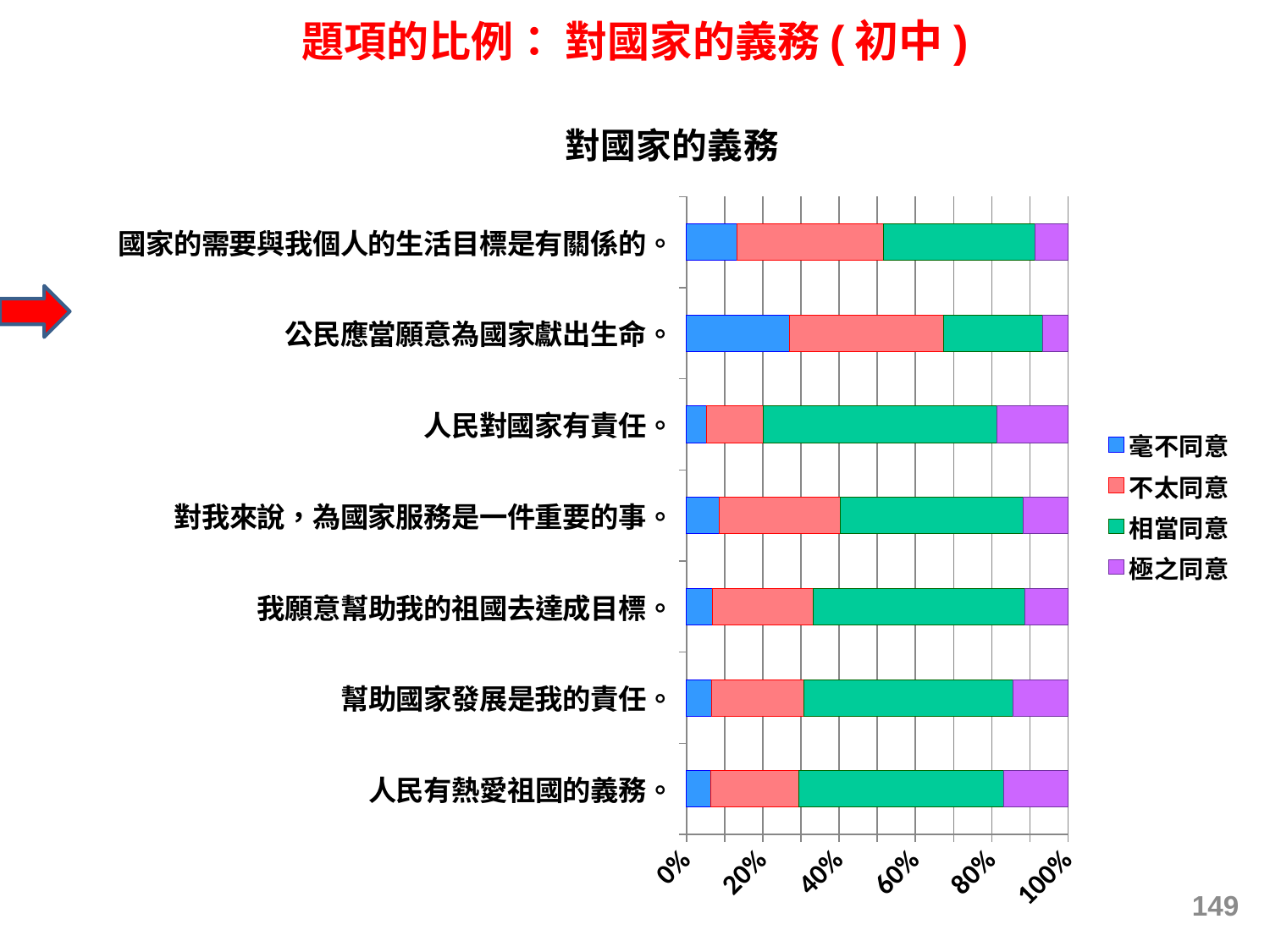
What is the title of the chart? 對國家的義務 Is the 毫不同意 share for 公民應當願意為國家獻出生命 greater or less than 20%? greater How many statements (categories) are plotted in the chart? 7 How many series does the legend list? 4 Is the 相當同意 share for 人民對國家有責任 greater or less than 40%? greater Which statement has the largest 相當同意 segment? 人民對國家有責任。 Which statement has the smallest 毫不同意 segment? 人民對國家有責任。 Which statement has a larger 極之同意 segment: 人民對國家有責任 or 公民應當願意為國家獻出生命? 人民對國家有責任。 Which legend entry is shown in green? 相當同意 Which statement has the largest 毫不同意 segment? 公民應當願意為國家獻出生命。 Which statement has the smallest 極之同意 segment? 公民應當願意為國家獻出生命。 What kind of chart is shown on the slide? Stacked bar chart